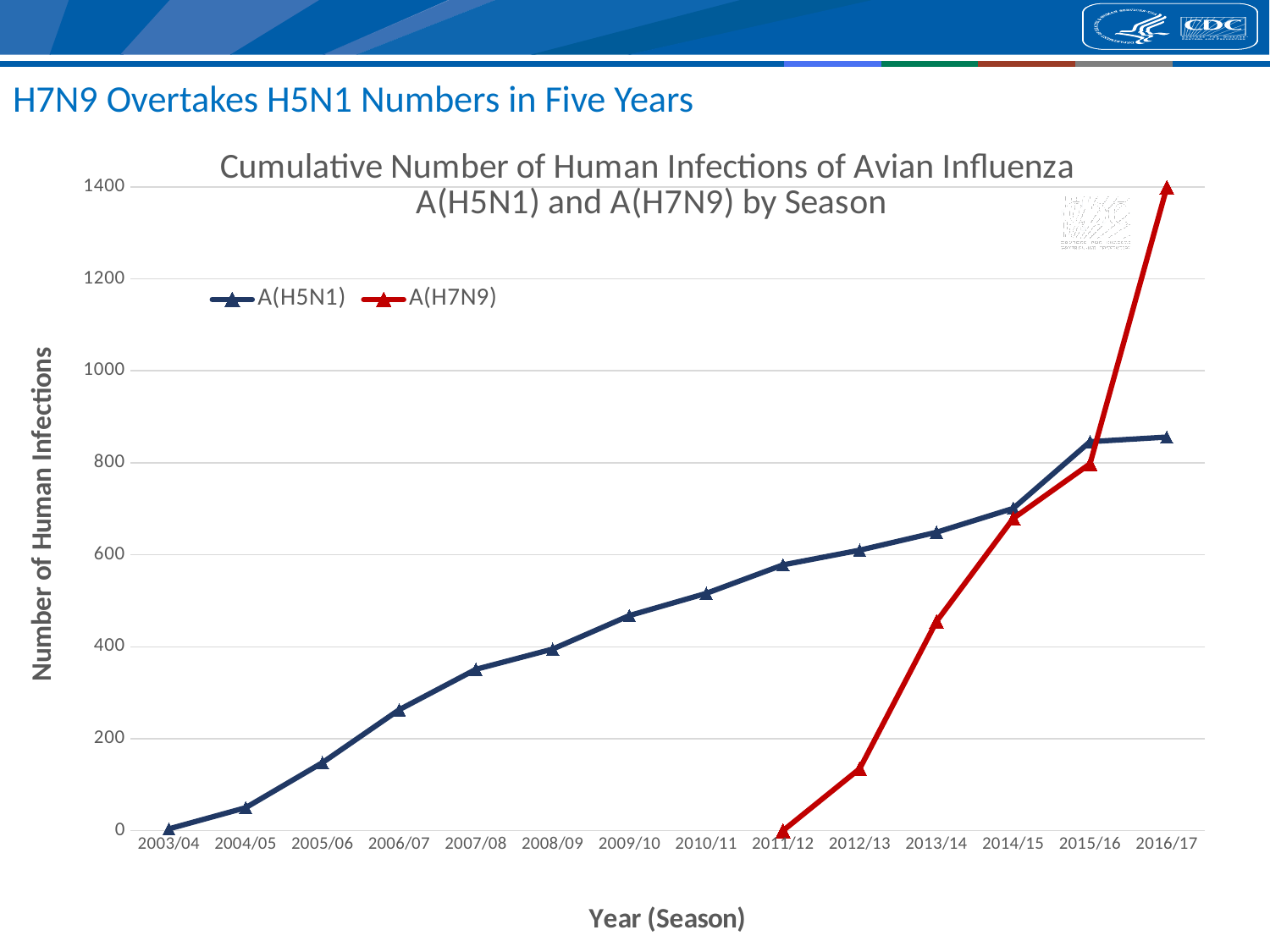
Is the value for A(H5N1) in 2007/08 greater or less than 400? less In 2013/14, which series has the larger value, A(H5N1) or A(H7N9)? A(H5N1) Is the value for A(H5N1) in 2016/17 greater or less than 800? greater Is the value for A(H7N9) in 2016/17 greater or less than 1200? greater Which series reaches the highest value on the chart? A(H7N9) How many series does the chart legend list? 2 In which season does the A(H7N9) series reach its highest value? 2016/17 In 2016/17, which series has the larger value, A(H5N1) or A(H7N9)? A(H7N9) What kind of chart is shown on the slide? line chart Do the A(H5N1) values rise or fall from 2003/04 to 2016/17? rise How many seasons are shown along the x axis of the chart? 14